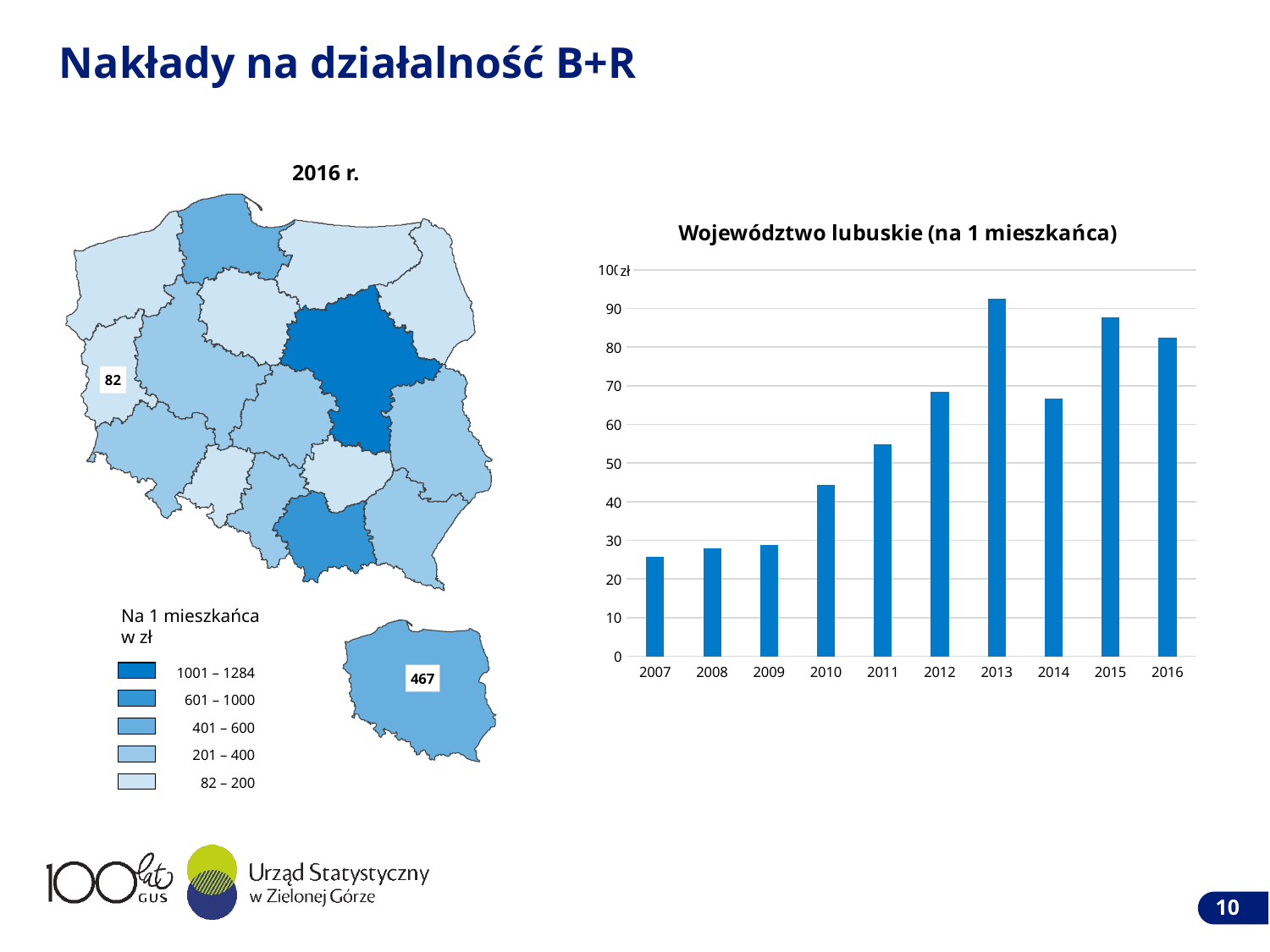
In the 'Województwo lubuskie (na 1 mieszkańca)' chart, which year has the lowest value? 2007 How many years are shown on the x axis of the 'Województwo lubuskie (na 1 mieszkańca)' chart? 10 What is the first year shown on the x axis of the 'Województwo lubuskie (na 1 mieszkańca)' chart? 2007 In the 'Województwo lubuskie (na 1 mieszkańca)' chart, do the values rise or fall from 2007 to 2013? rise In the 'Województwo lubuskie (na 1 mieszkańca)' chart, is the value for 2013 greater or less than 90? greater What kind of chart is 'Województwo lubuskie (na 1 mieszkańca)'? bar chart In the 'Województwo lubuskie (na 1 mieszkańca)' chart, which is larger, the value for 2015 or the value for 2016? 2015 In the 'Województwo lubuskie (na 1 mieszkańca)' chart, is the value for 2011 greater or less than 50? greater In the 'Województwo lubuskie (na 1 mieszkańca)' chart, is the value for 2007 greater or less than 30? less In the 'Województwo lubuskie (na 1 mieszkańca)' chart, which is larger, the value for 2013 or the value for 2014? 2013 In the 'Województwo lubuskie (na 1 mieszkańca)' chart, which year has the highest value? 2013